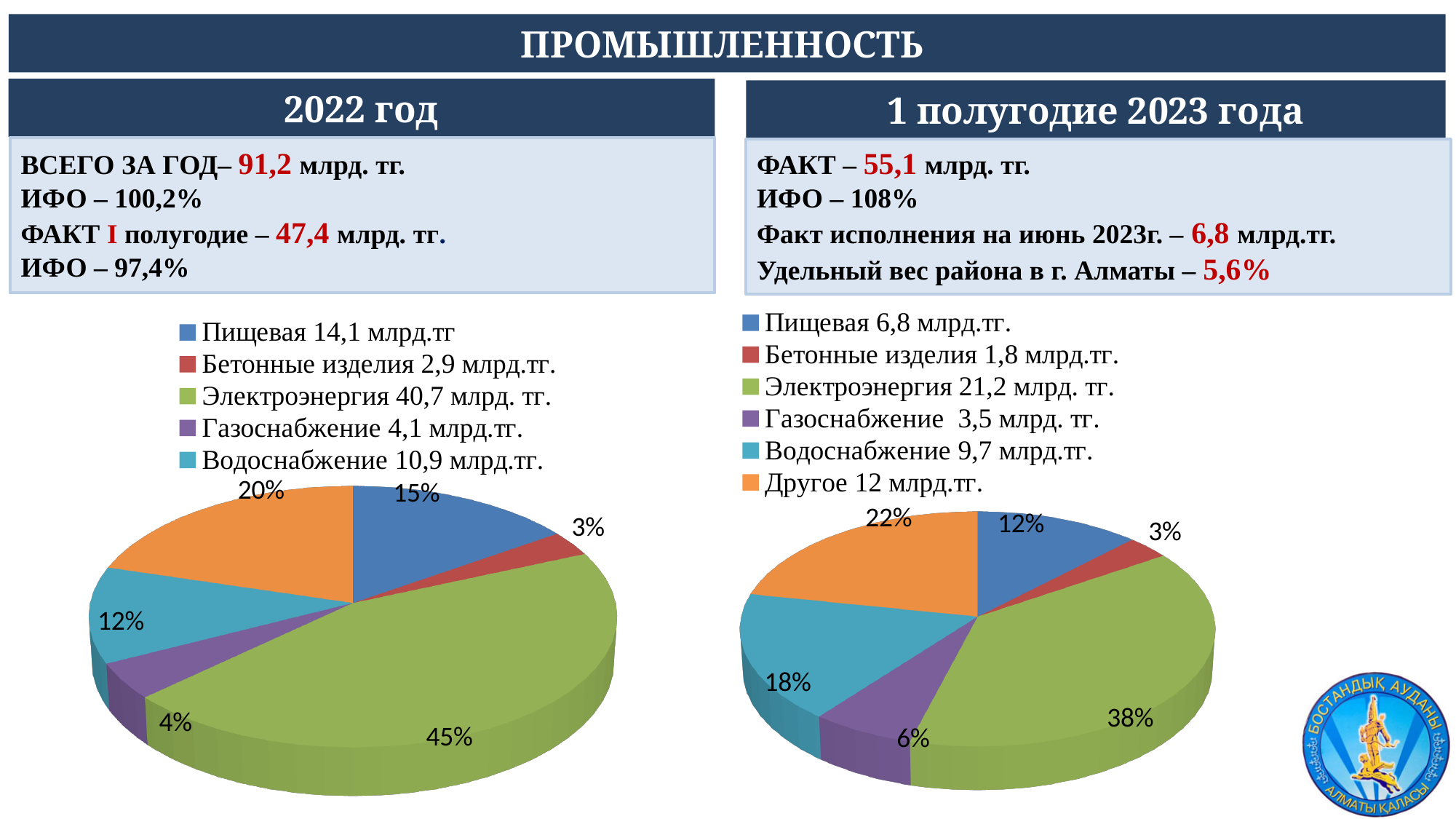
In the 1 полугодие 2023 года pie chart, what share does Другое have? 22% How many entries does the legend of the 1 полугодие 2023 года pie chart list? 6 In the 1 полугодие 2023 года pie chart, what is the difference in percentage points between the Электроэнергия share and the Другое share? 16 In the 2022 год chart legend, what value is given for Пищевая? 14,1 млрд.тг In the 2022 год pie chart, which category has the largest share? Электроэнергия What type of chart is used on the left side of the slide for 2022 год? pie chart In the 1 полугодие 2023 года pie chart, what share does Электроэнергия have? 38% In the 2022 год pie chart, what share does Электроэнергия have? 45% In the 1 полугодие 2023 года pie chart, which is larger: the share of Водоснабжение or the share of Пищевая? Водоснабжение In the 1 полугодие 2023 года chart legend, what value is given for Газоснабжение? 3,5 млрд. тг. In the 2022 год pie chart, which category has the smallest share? Бетонные изделия